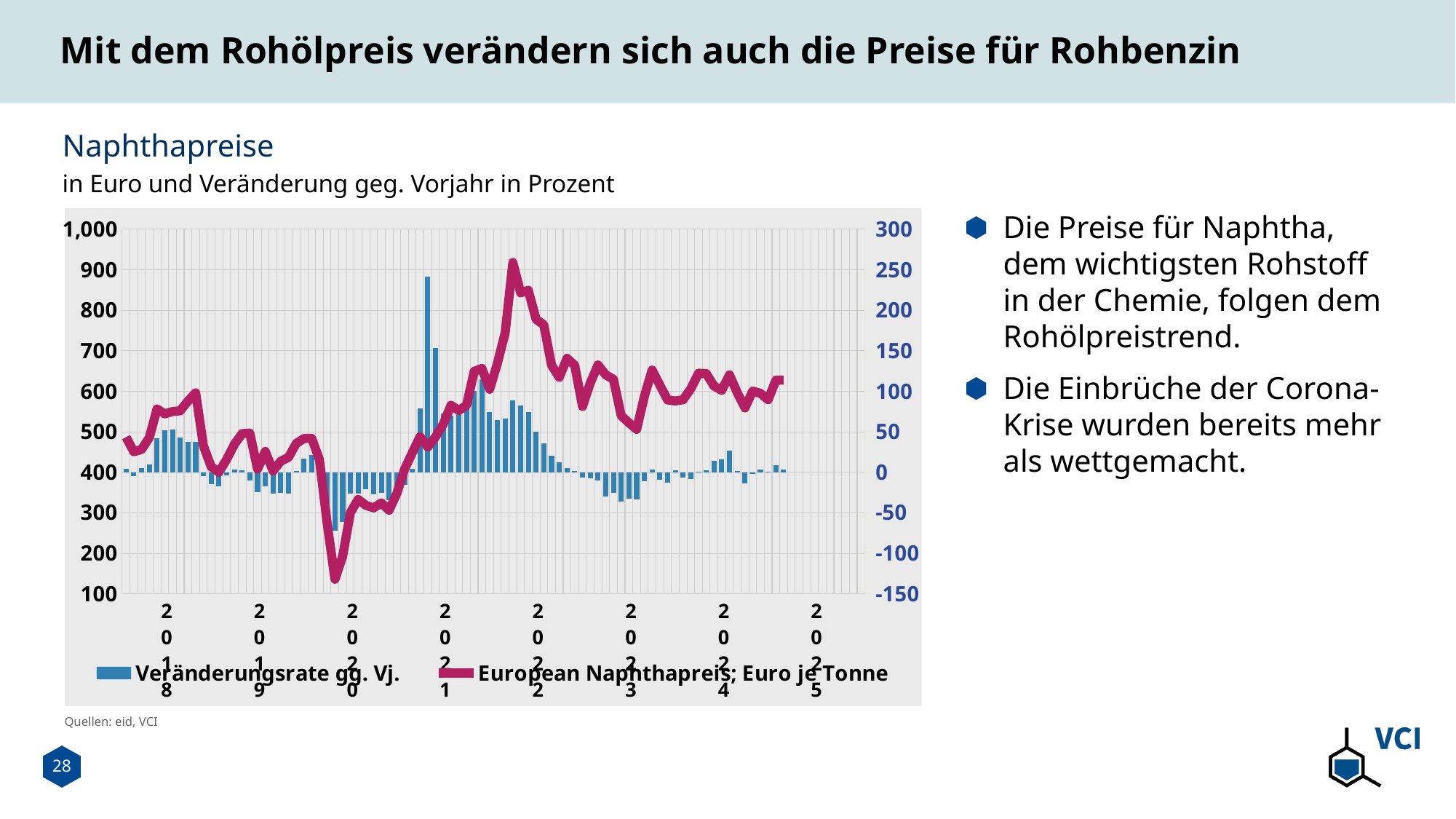
Does the European Naphthapreis line rise or fall between 2020 and 2022? rise What is the title of the chart? Naphthapreise Are the Veränderungsrate gg. Vj. bars in 2020 greater or less than 0? less Which series is drawn as a line in the chart? European Naphthapreis; Euro je Tonne Is the lowest value of the European Naphthapreis line in 2020 greater or less than 200? less Is the peak value of the European Naphthapreis line in 2022 greater or less than 800? greater Does the European Naphthapreis line rise or fall between 2018 and 2020? fall In which year does the European Naphthapreis line reach its highest value? 2022 How many series does the chart legend list? 2 What kind of chart is shown on the slide? A combined bar and line chart In which year does the European Naphthapreis line reach its lowest value? 2020